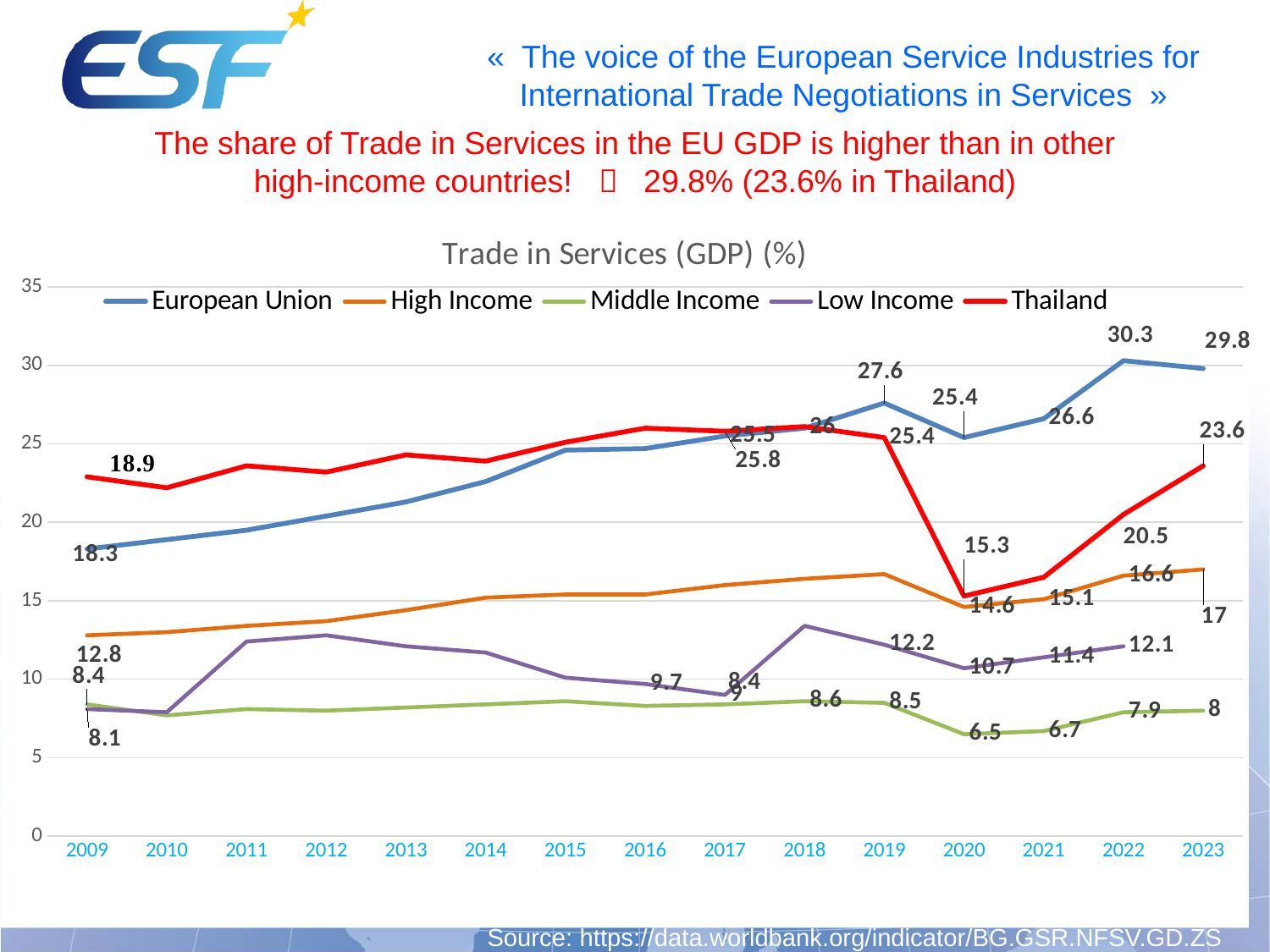
Is the Thailand value for 2009 greater or less than 20? greater In which year does the Middle Income series reach its lowest value? 2020 What is the difference between the European Union and Thailand values in 2023? 6.2 Which is larger in 2023, the European Union value or the High Income value? European Union What is the High Income value for 2009? 12.8 What is the European Union value for 2023? 29.8 How many series does the legend of the 'Trade in Services (GDP) (%)' chart list? 5 What type of chart is shown on the slide? line chart How many years are shown on the x axis of the chart? 15 What is the Thailand value for 2020? 15.3 In which year does the European Union series reach its highest value? 2022